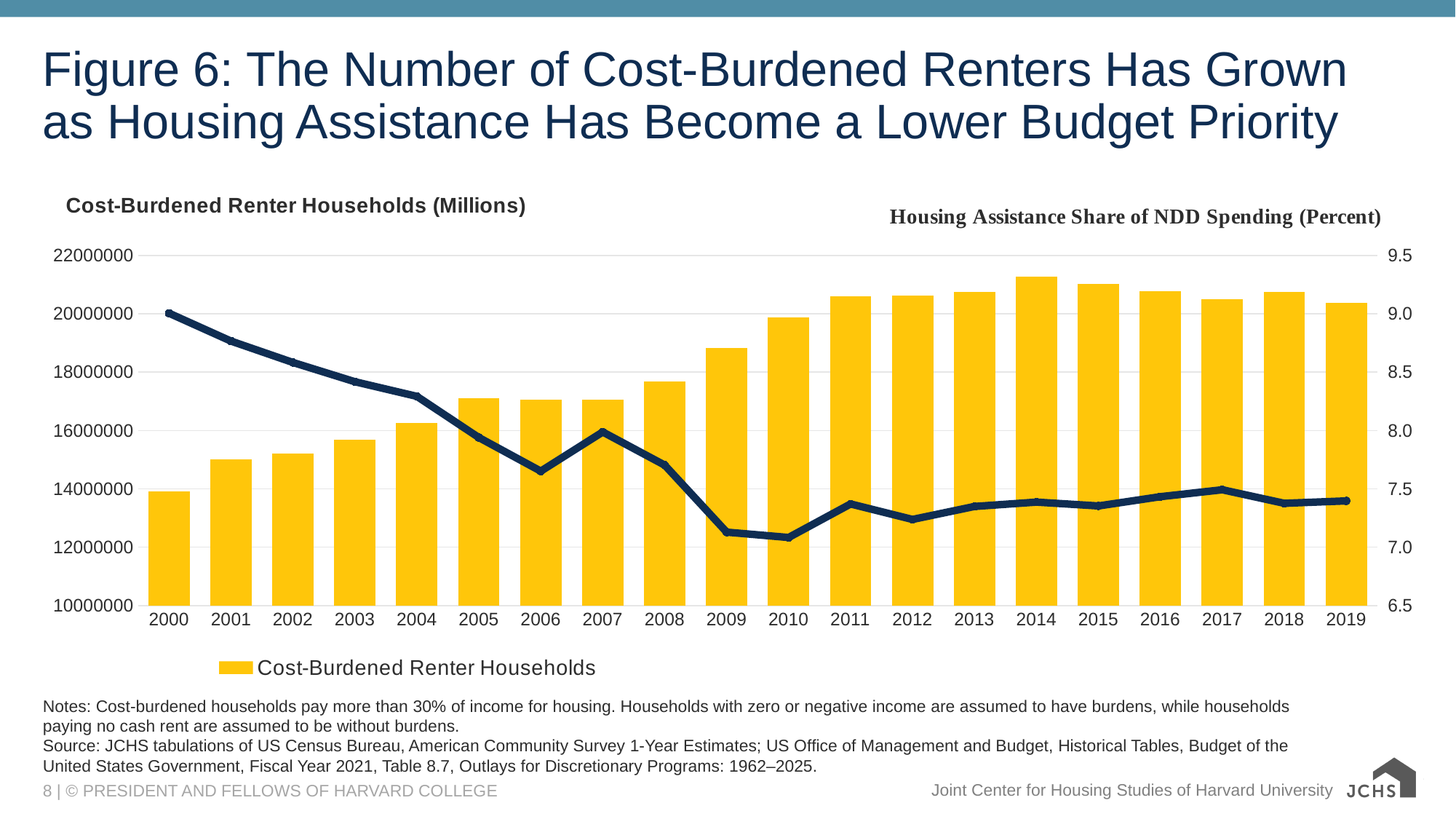
What kind of chart is shown on the slide? A bar chart combined with a line chart Which year has the shortest bar for Cost-Burdened Renter Households? 2000 Is the Housing Assistance Share of NDD Spending for 2010 greater or less than 7.5? less Is the Housing Assistance Share of NDD Spending for 2003 greater or less than 8.5? less How many series does the legend list? 1 Does the Housing Assistance Share of NDD Spending line rise or fall from 2000 to 2010? fall What is the title of the right-hand axis of the chart? Housing Assistance Share of NDD Spending (Percent) Which year has the tallest bar for Cost-Burdened Renter Households? 2014 How many years are shown along the x axis of the chart? 20 Is the Cost-Burdened Renter Households value for 2019 greater or less than 20000000? greater Which year has the larger Cost-Burdened Renter Households bar, 2008 or 2009? 2009